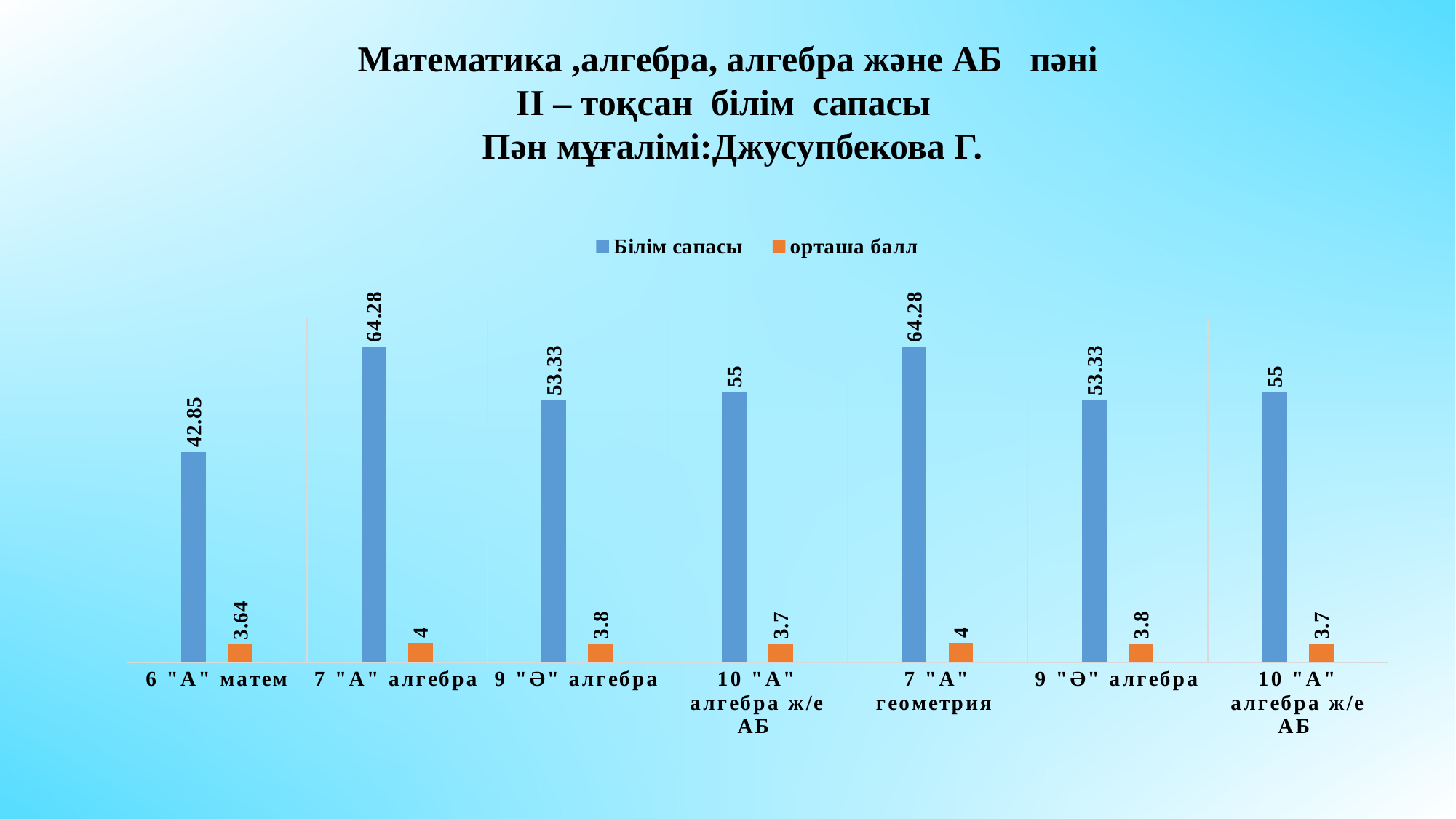
How many categories are shown on the x axis? 7 What is the difference between the Білім сапасы values for 7 "А" алгебра and 6 "А" матем? 21.43 Which colour represents the орташа балл series? Orange Which category has the lowest орташа балл value? 6 "А" матем What is the Білім сапасы value for 9 "Ә" алгебра? 53.33 What is the орташа балл value for 10 "А" алгебра ж/е АБ? 3.7 Which category has the lowest Білім сапасы value? 6 "А" матем Which is larger, the Білім сапасы value for 7 "А" алгебра or for 10 "А" алгебра ж/е АБ? 7 "А" алгебра How many series does the legend list? 2 What kind of chart is shown on the slide? Bar chart What is the орташа балл value for 7 "А" геометрия? 4 What is the Білім сапасы value for 6 "А" матем? 42.85